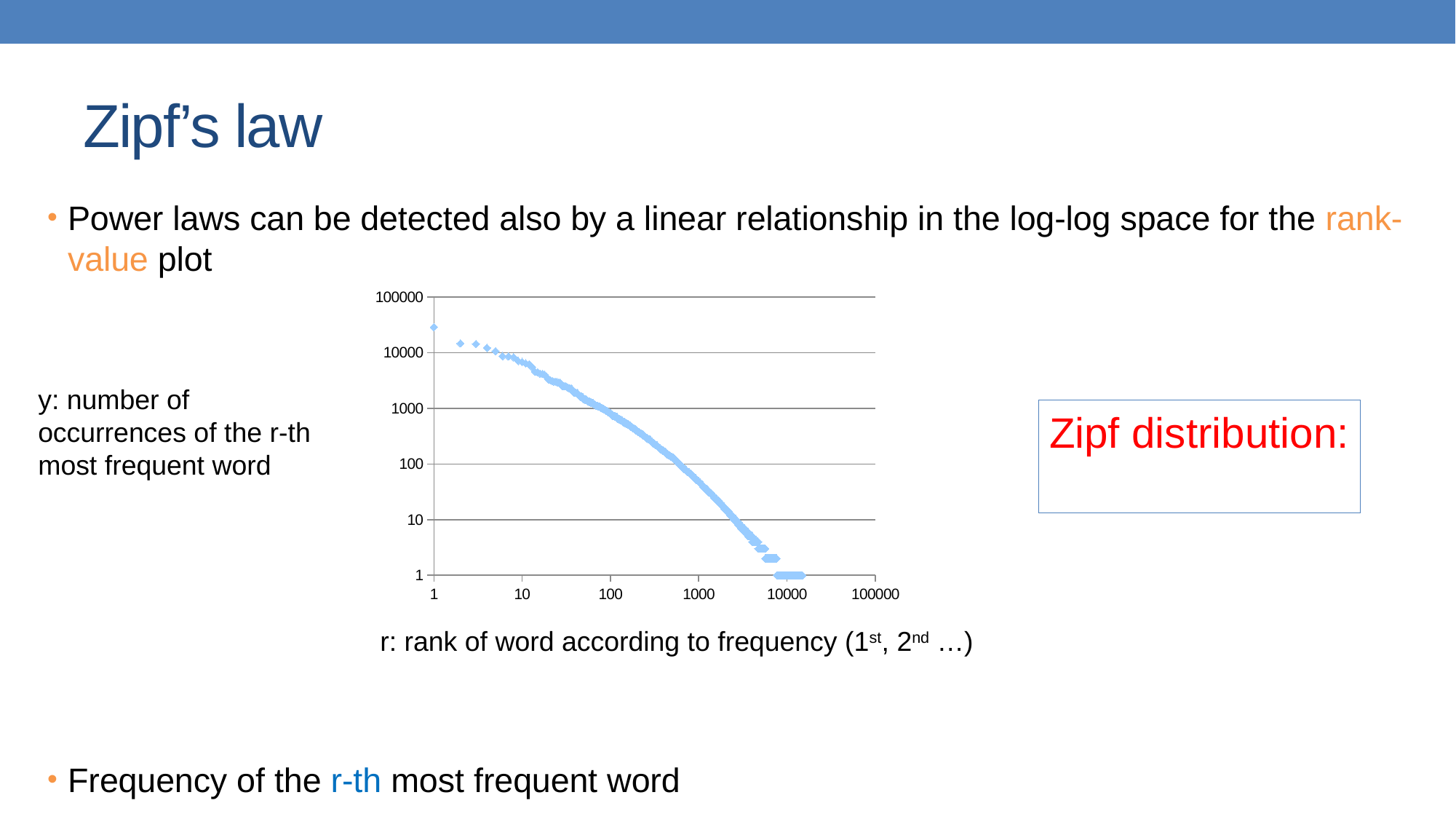
Is the value plotted at rank 10 greater or less than 1000? greater What is the highest tick label shown on the y axis? 100000 Is the value plotted at rank 1 larger or smaller than the value plotted at rank 1000? larger Do the plotted values rise or fall as the rank increases along the x axis? fall Is the value plotted at rank 100 greater or less than 100? greater At which rank on the x axis does the chart reach its highest value? 1 Is the value plotted at rank 1000 greater or less than 1000? less What is the lowest tick label shown on the x axis? 1 What kind of chart is shown on the slide? scatter chart